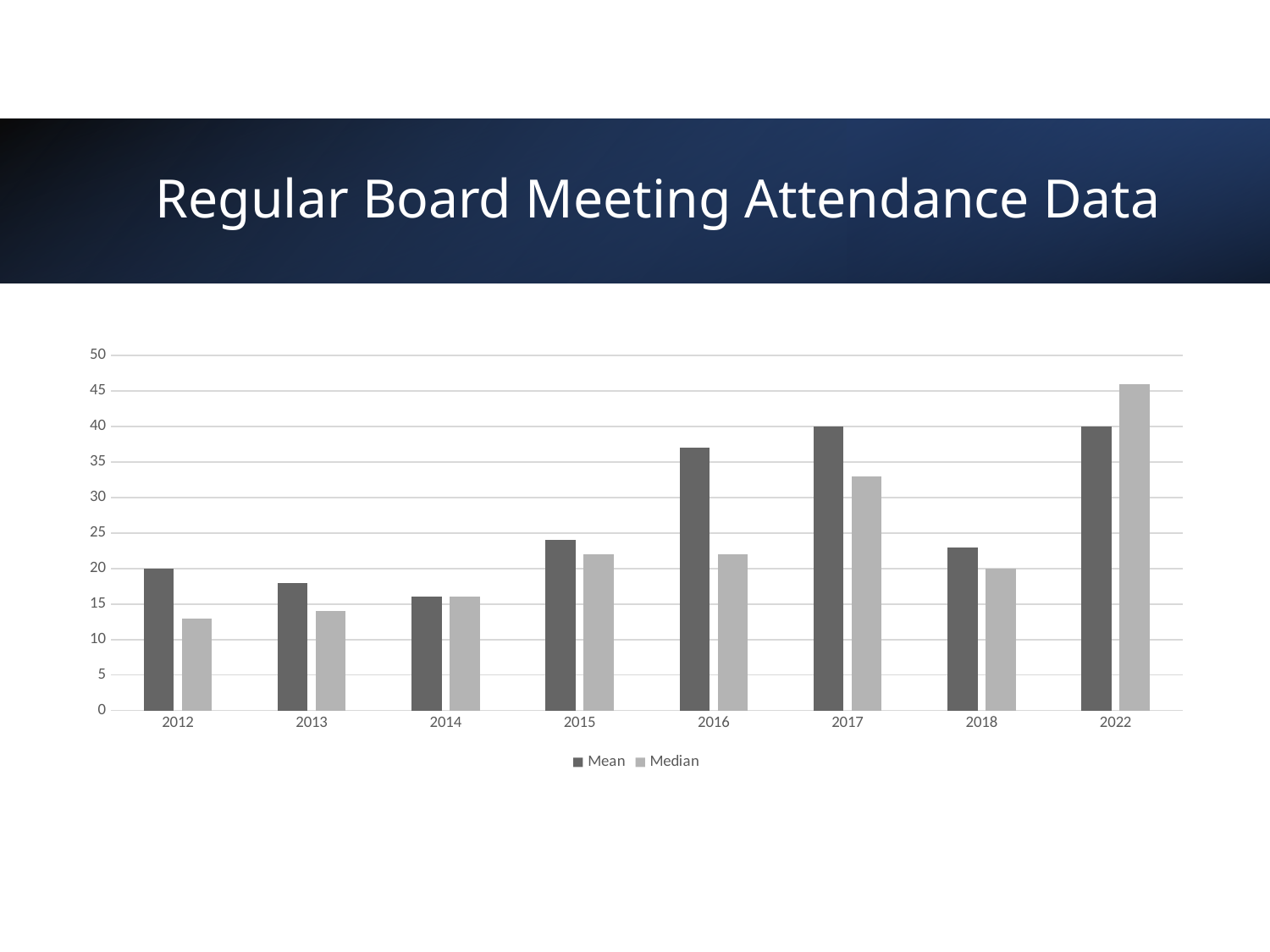
Is the Median value for 2012 greater or less than 15? less What is the Median value for 2018? 20 Is the Median value for 2022 greater or less than 40? greater What is the Mean value for 2012? 20 Which year has the highest Median value? 2022 In 2022, which is larger, the Mean or the Median? Median What is the Mean value for 2017? 40 Does the Mean value rise or fall from 2013 to 2017? rise How many series does the legend list? 2 How many years are shown on the x axis? 8 What type of chart is shown on the slide? bar chart What is the title of the chart? Regular Board Meeting Attendance Data